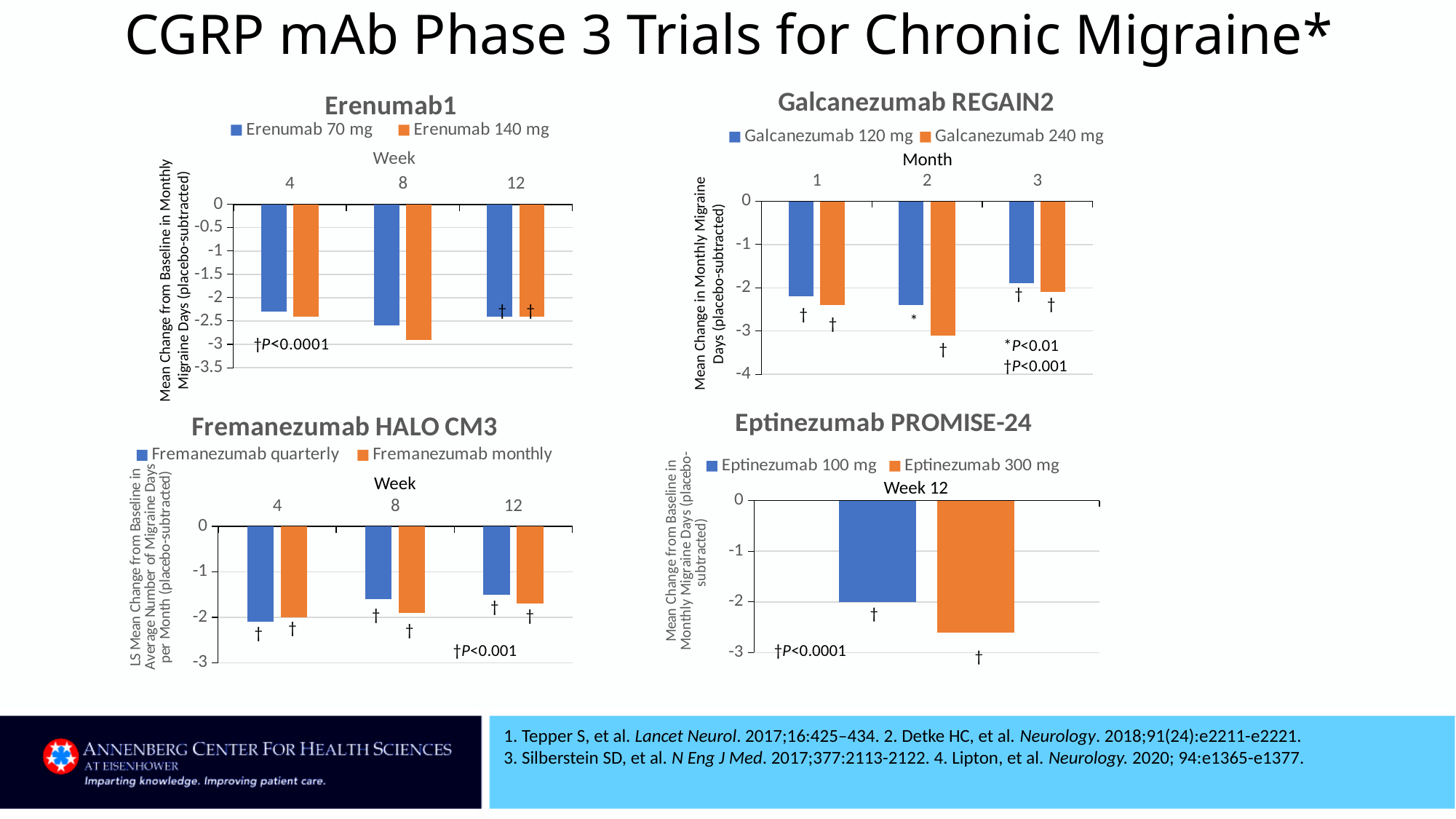
In the Erenumab1 chart, what kind of chart is used? bar chart In the Erenumab1 chart, how many week time points are plotted on the x axis? 3 In the Erenumab1 chart, is the value for Erenumab 140 mg at Week 8 greater or less than -2.5? less In the Erenumab1 chart, how many series does the legend list? 2 In the Fremanezumab HALO CM3 chart, is the value for Fremanezumab quarterly at Week 12 greater or less than -2? greater In the Erenumab1 chart, at Week 8, which dose shows the larger reduction in monthly migraine days, 70 mg or 140 mg? Erenumab 140 mg In the Galcanezumab REGAIN2 chart, what are the two series listed in the legend? Galcanezumab 120 mg and Galcanezumab 240 mg In the Eptinezumab PROMISE-24 chart, is the value for Eptinezumab 300 mg at Week 12 greater or less than -2? less In the Galcanezumab REGAIN2 chart, at Month 2, which dose shows the larger reduction in monthly migraine days, 120 mg or 240 mg? Galcanezumab 240 mg In the Fremanezumab HALO CM3 chart, do the Fremanezumab quarterly bars become more negative or less negative from Week 4 to Week 12? less negative How many charts are shown on the slide? 4